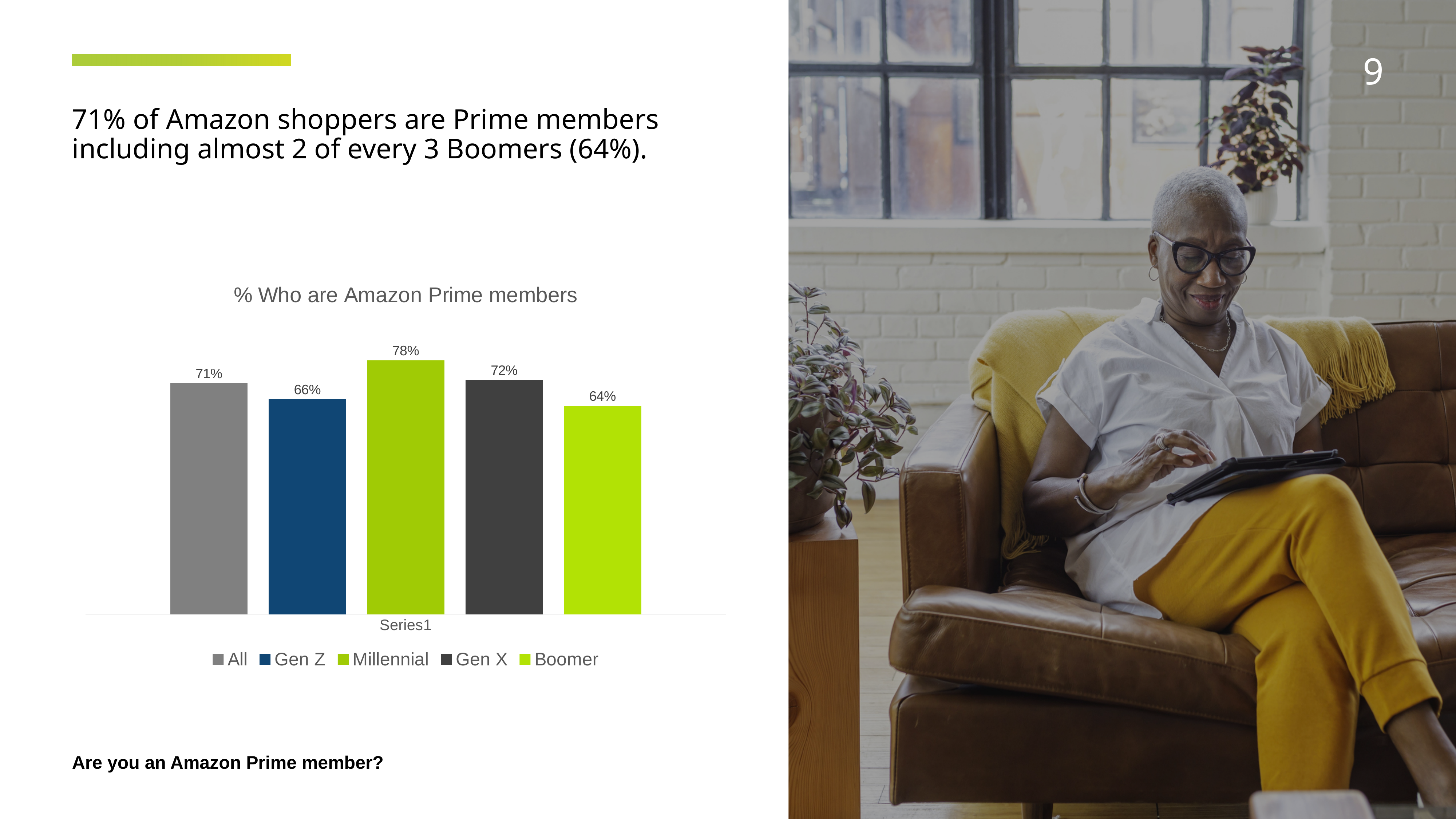
What is the title of the chart? % Who are Amazon Prime members Which is larger, the value for Gen X or the value for Gen Z? Gen X What type of chart is shown on the slide? Bar chart How many bars are shown in the chart? 5 What is the value for All in the chart? 71% What is the value for Millennial in the chart? 78% Which group has the highest percentage of Amazon Prime members? Millennial What is the difference between the Gen X and Gen Z values? 6% What is the difference between the Millennial and Boomer values? 14% What is the value for Boomer in the chart? 64% What is the value for Gen Z in the chart? 66% Which group has the lowest percentage of Amazon Prime members? Boomer